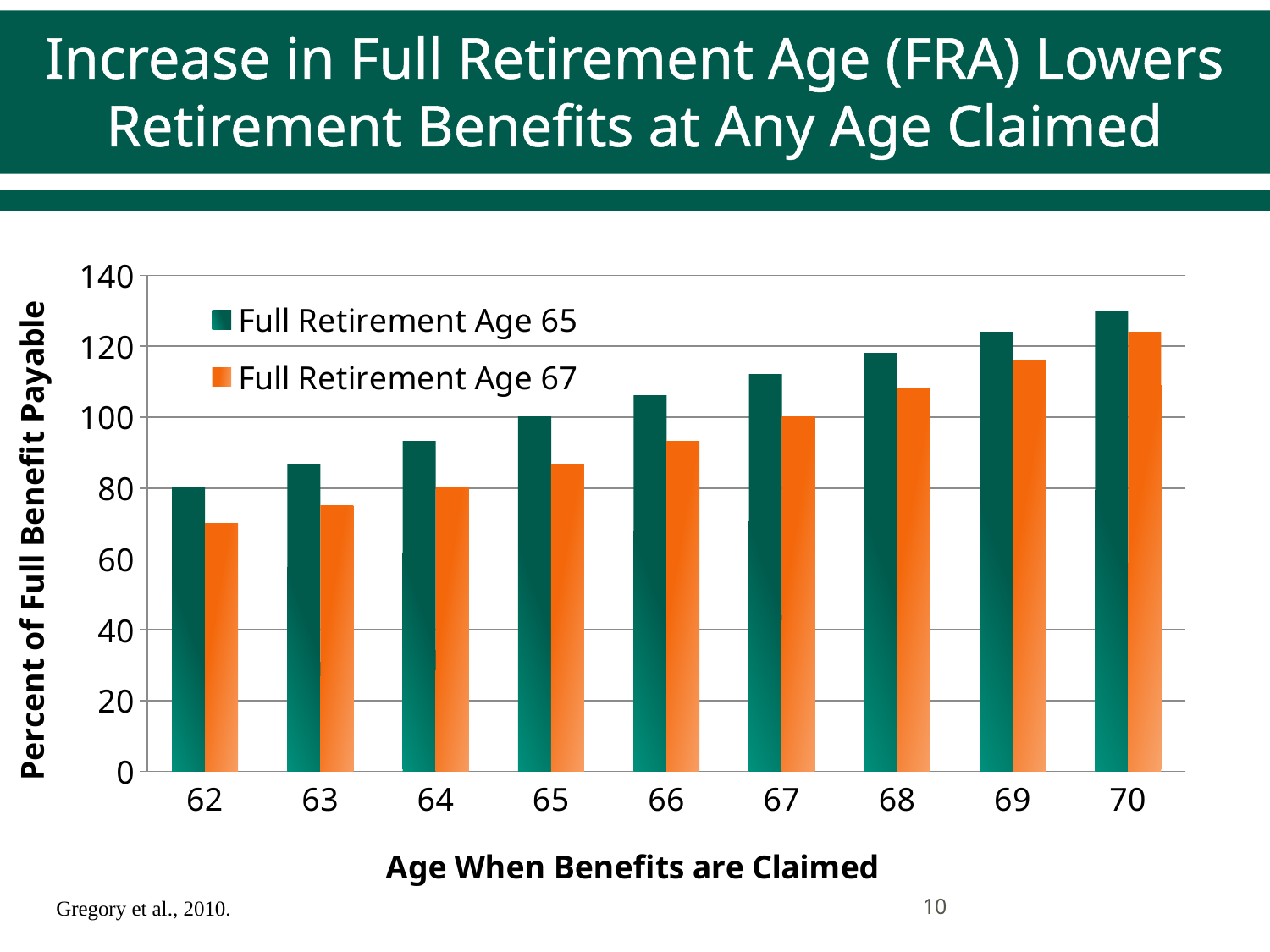
What kind of chart is shown on the slide? bar chart What is the value for Full Retirement Age 67 at age 64? 80 At which claiming age is the Full Retirement Age 67 series lowest? 62 What is the value for Full Retirement Age 65 at age 62? 80 How many series does the legend list? 2 Is the value for Full Retirement Age 67 at age 62 greater or less than 80? less What is the value for Full Retirement Age 67 at age 67? 100 How many claiming ages are shown on the x axis? 9 What is the value for Full Retirement Age 65 at age 65? 100 Do the values rise or fall as the claiming age increases? rise At which claiming age is the Full Retirement Age 65 series highest? 70 Is the value for Full Retirement Age 65 at age 70 greater or less than 120? greater